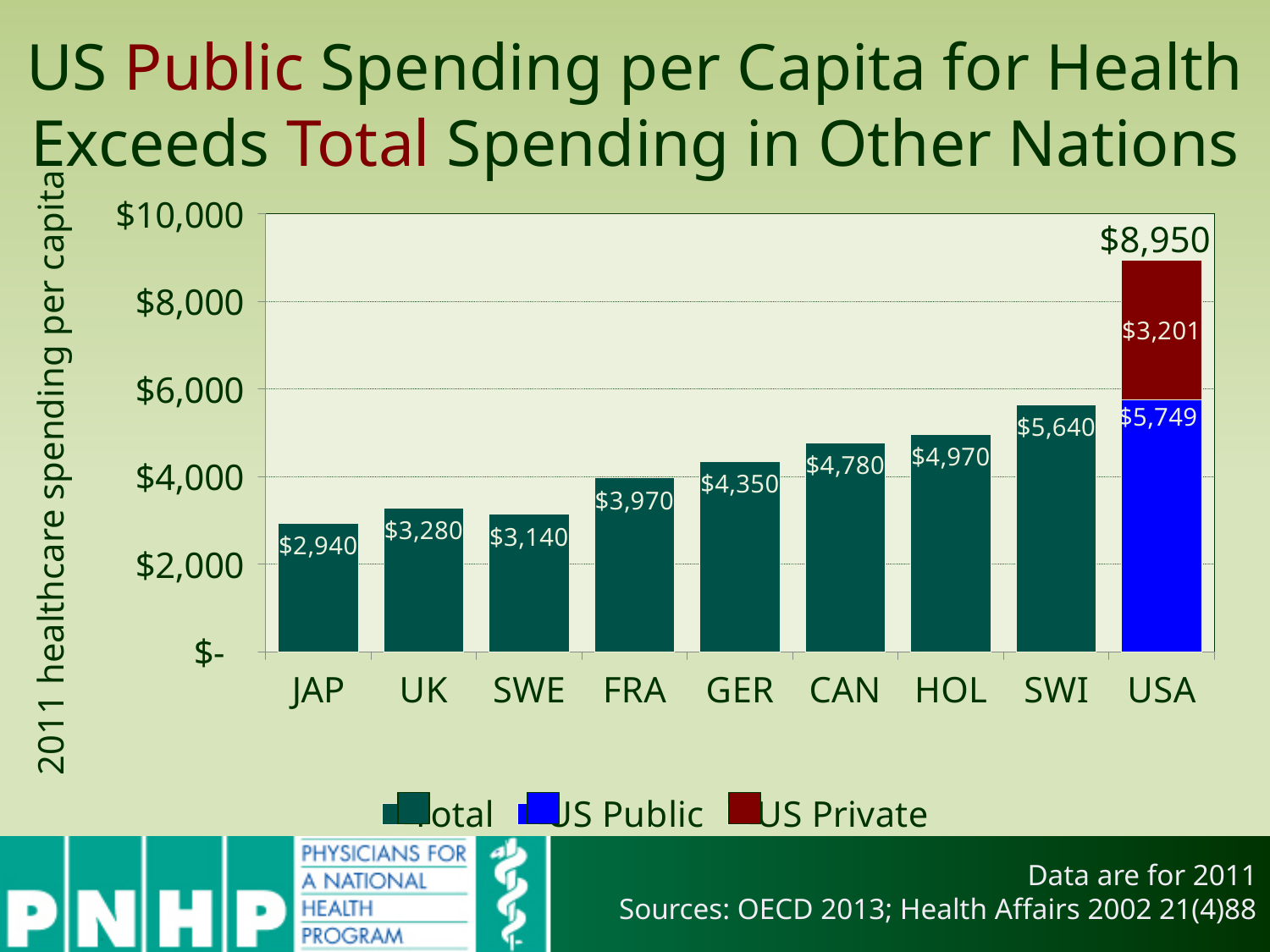
What is the US Public spending per capita shown for the USA? $5,749 Which country has the highest healthcare spending per capita? USA Which has higher total spending per capita, the UK or Sweden (SWE)? UK What kind of chart is shown on the slide? Bar chart What colour is the US Private portion of the USA bar? Dark red What is the total healthcare spending per capita for Japan (JAP)? $2,940 What is the difference between the total spending per capita for Switzerland (SWI) and Canada (CAN)? $860 How many series does the legend list? 3 What is the total spending per capita shown above the USA bar? $8,950 Which country has the lowest healthcare spending per capita? JAP What is the US Private spending per capita shown for the USA? $3,201 How many countries are shown on the x axis? 9